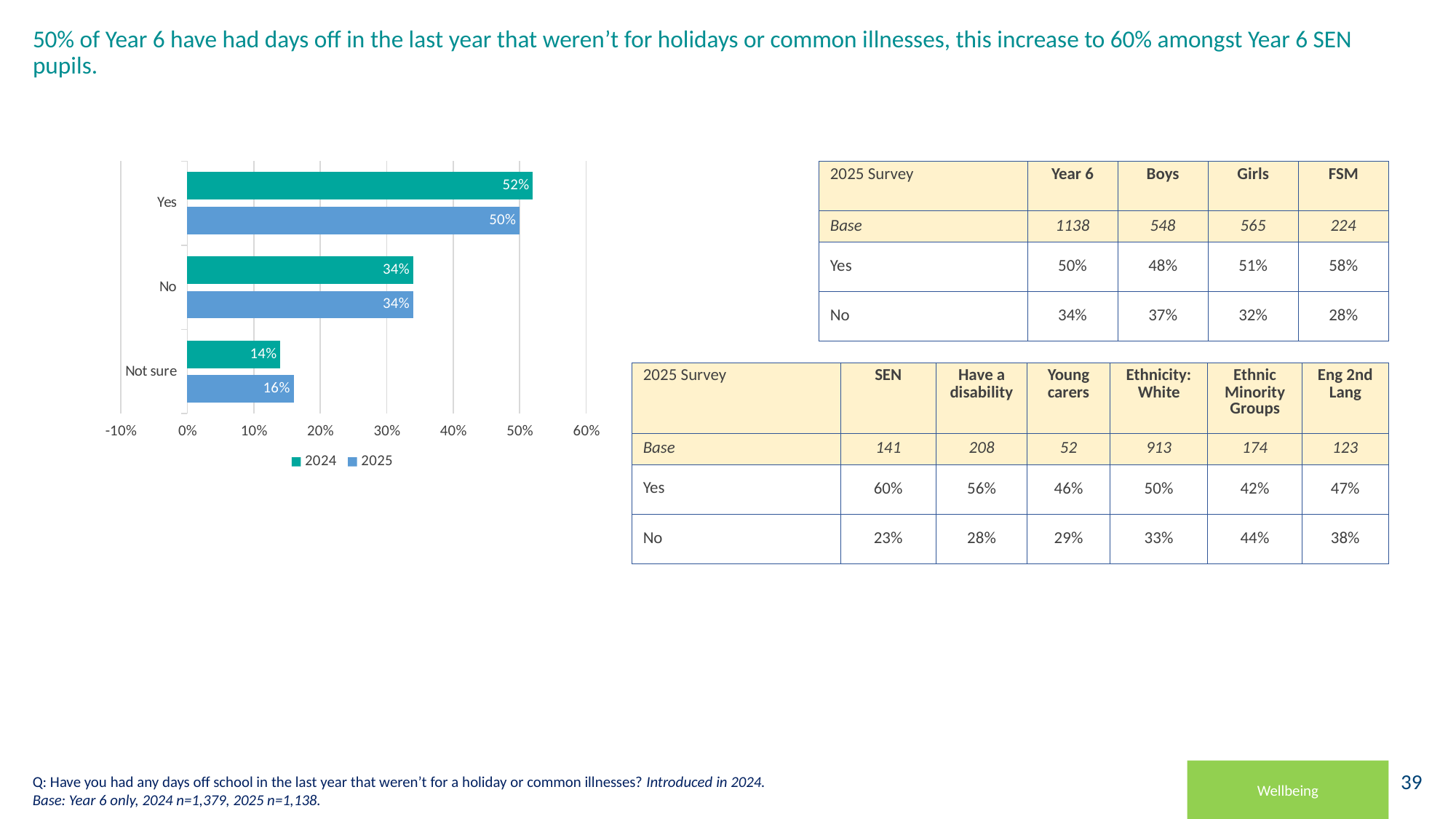
What is the 2025 value for Not sure? 16% How many series does the legend list? 2 Is the 2024 value for Yes greater or less than 50%? greater What kind of chart is shown on the slide? bar chart What is the 2025 value for No? 34% Which is larger for Not sure, the 2024 value or the 2025 value? 2025 What is the 2024 value for Yes? 52% Which colour represents the 2024 series in the chart? green Which category has the highest 2025 value? Yes What is the difference between the 2024 and 2025 values for Yes? 2% Which category has the lowest 2024 value? Not sure How many categories are shown on the chart? 3